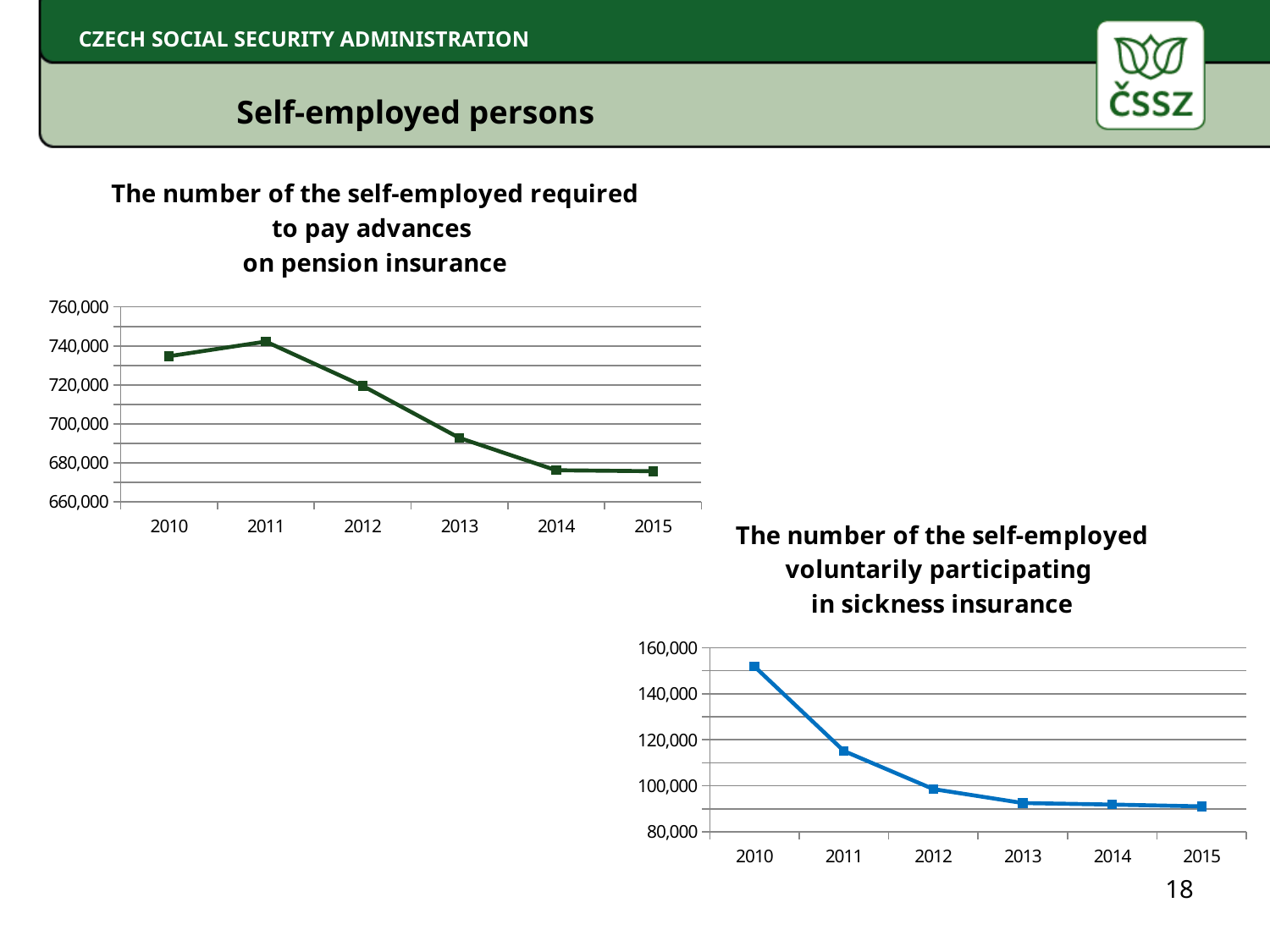
In the chart titled 'The number of the self-employed required to pay advances on pension insurance', is the value for 2013 greater or less than 700,000? less In the chart titled 'The number of the self-employed required to pay advances on pension insurance', is the value for 2014 greater or less than 680,000? less In the chart titled 'The number of the self-employed required to pay advances on pension insurance', which year has the highest value? 2011 In the chart titled 'The number of the self-employed required to pay advances on pension insurance', which is larger, the value for 2012 or the value for 2013? 2012 In the chart titled 'The number of the self-employed voluntarily participating in sickness insurance', which year has the highest value? 2010 In the chart titled 'The number of the self-employed required to pay advances on pension insurance', is the value for 2010 greater or less than 720,000? greater What kind of chart is the one titled 'The number of the self-employed voluntarily participating in sickness insurance'? line chart In the chart titled 'The number of the self-employed voluntarily participating in sickness insurance', do the values generally rise or fall from 2010 to 2015? fall What colour is the line in the chart titled 'The number of the self-employed voluntarily participating in sickness insurance'? blue In the chart titled 'The number of the self-employed required to pay advances on pension insurance', how many years are plotted on the x axis? 6